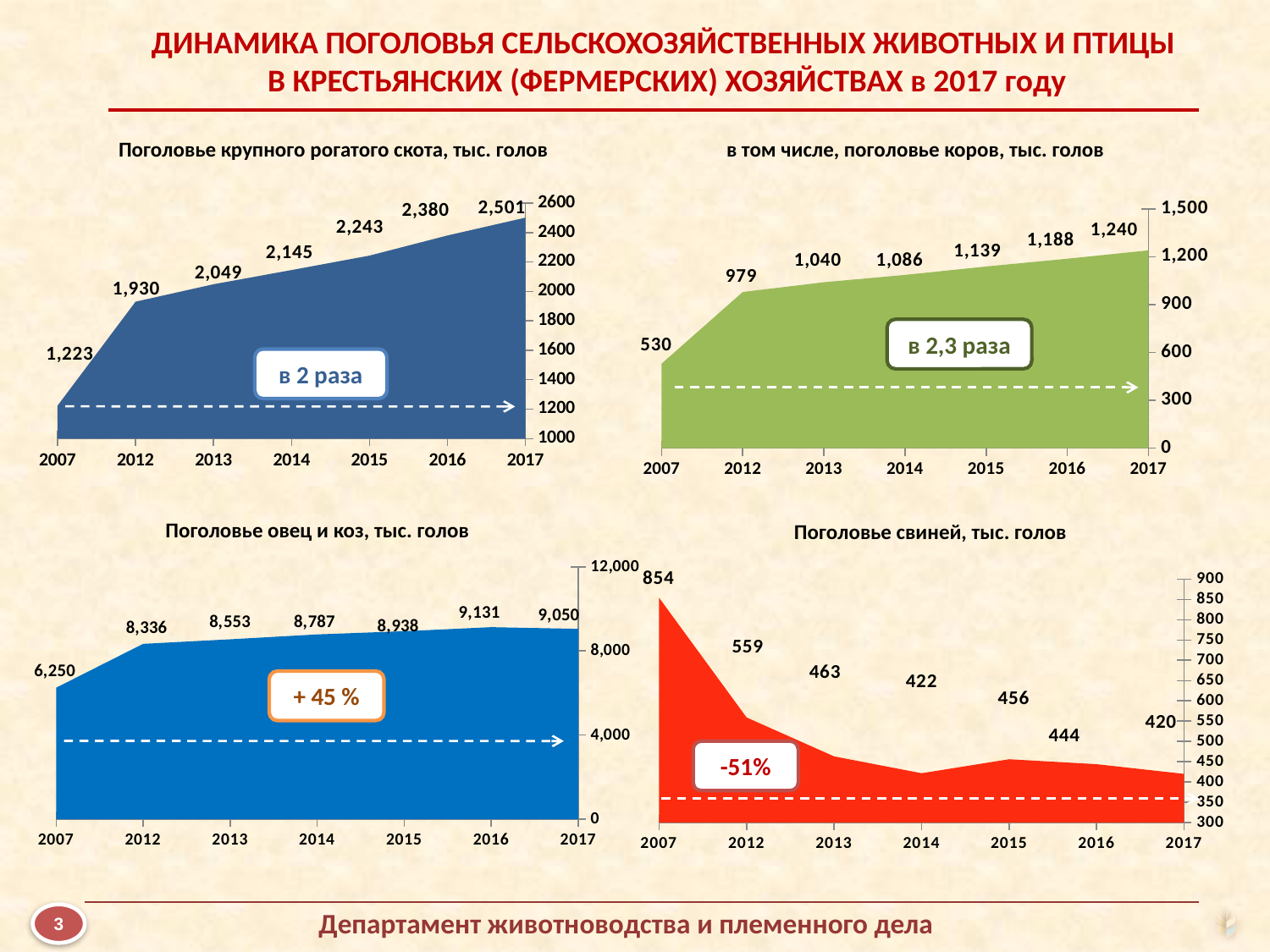
In the chart 'в том числе, поголовье коров, тыс. голов', which year has the lowest value? 2007 In the chart 'Поголовье крупного рогатого скота, тыс. голов', what is the value for 2017? 2,501 What type of chart is 'Поголовье овец и коз, тыс. голов'? area chart In the chart 'Поголовье свиней, тыс. голов', do the values generally rise or fall from 2007 to 2017? fall In the chart 'Поголовье крупного рогатого скота, тыс. голов', what is the difference between the 2017 and 2007 values? 1,278 In the chart 'Поголовье свиней, тыс. голов', what is the value for 2007? 854 In the chart 'Поголовье свиней, тыс. голов', which is larger, the value for 2015 or the value for 2016? 2015 What percentage change is shown in the label box on the chart 'Поголовье свиней, тыс. голов'? -51% In the chart 'в том числе, поголовье коров, тыс. голов', what is the value for 2012? 979 How many years are plotted in the chart 'Поголовье крупного рогатого скота, тыс. голов'? 7 In the chart 'Поголовье овец и коз, тыс. голов', what is the value for 2014? 8,787 In the chart 'Поголовье овец и коз, тыс. голов', which year has the highest value? 2016